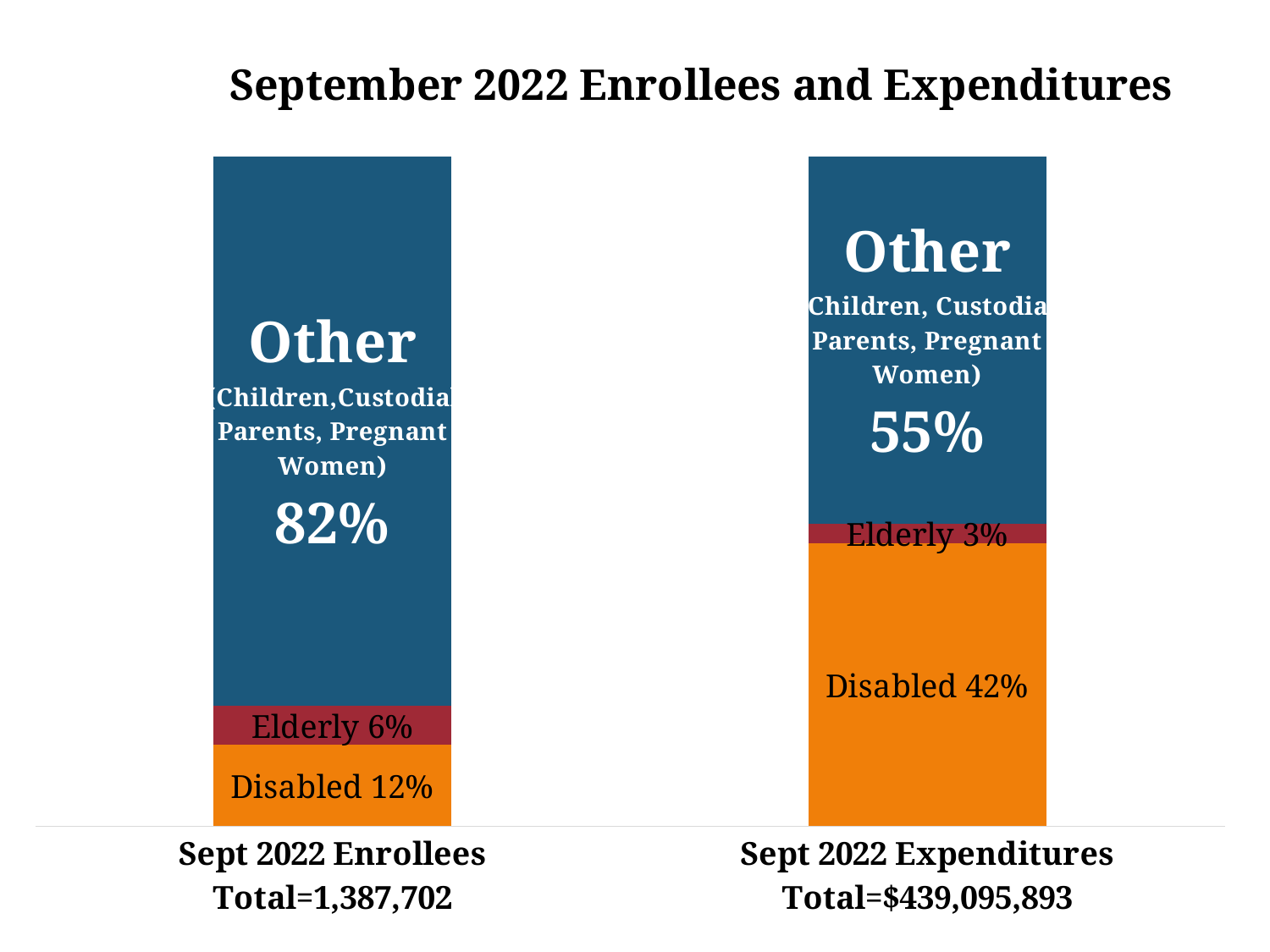
Which group has the smallest share of Sept 2022 Expenditures? Elderly What share of Sept 2022 Expenditures is Elderly? 3% How many segments make up each stacked bar? 3 What kind of chart is shown on the slide? Stacked bar chart What share of Sept 2022 Enrollees is Elderly? 6% What is the difference between the Disabled share of Sept 2022 Expenditures and the Disabled share of Sept 2022 Enrollees? 30% How many bars are shown in the chart? 2 What share of Sept 2022 Enrollees is Disabled? 12% What is the total shown for Sept 2022 Expenditures? $439,095,893 Which group has the largest share of Sept 2022 Enrollees? Other (Children, Custodial Parents, Pregnant Women) Is the Other share larger for Sept 2022 Enrollees or Sept 2022 Expenditures? Sept 2022 Enrollees What share of Sept 2022 Expenditures is Other (Children, Custodial Parents, Pregnant Women)? 55%